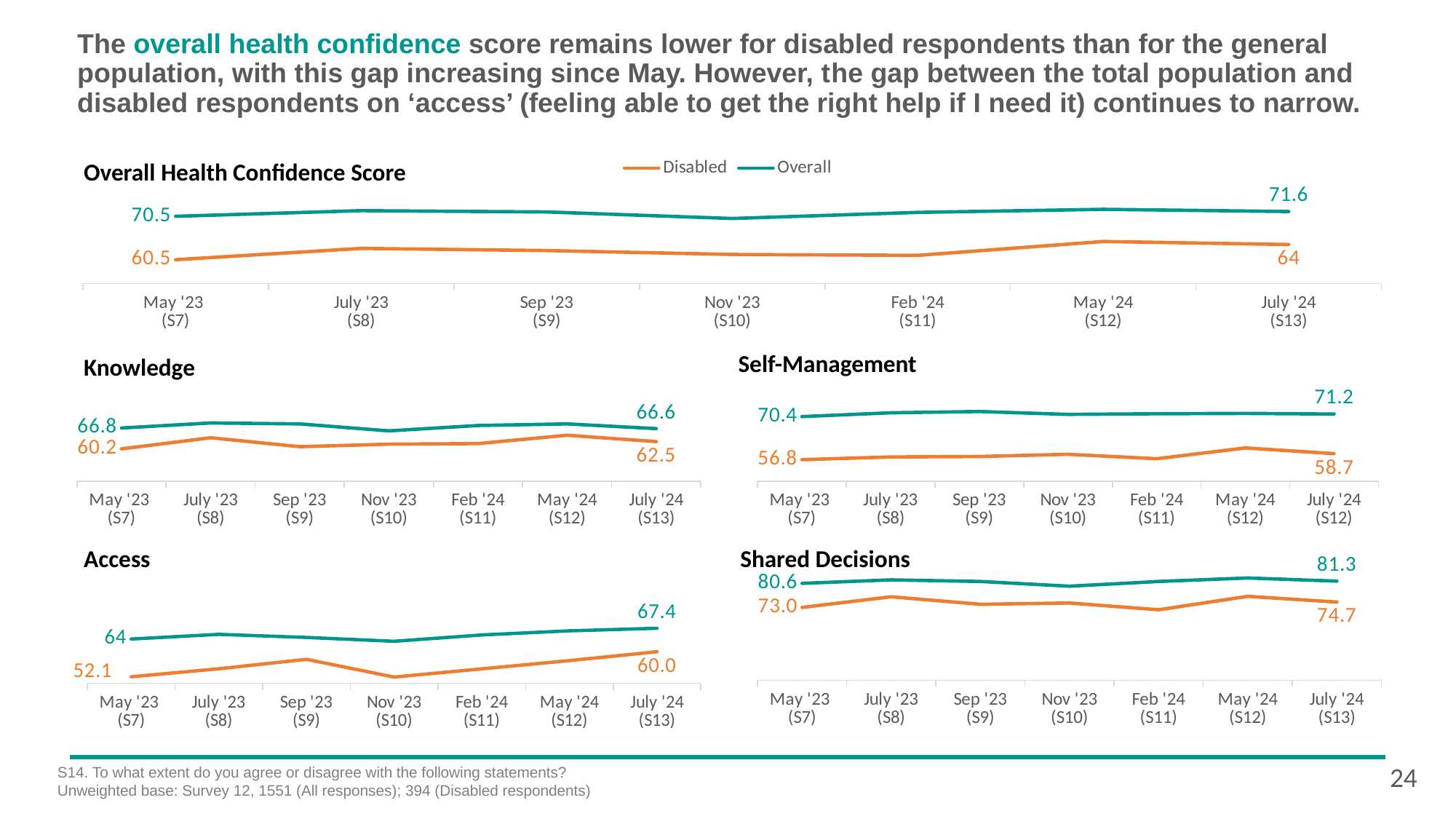
In the Shared Decisions chart, what is the Overall value for July '24 (S13)? 81.3 In the Access chart, does the Disabled line rise or fall between May '23 (S7) and July '24 (S13)? rise In the Access chart, what is the difference between the Overall and Disabled values at July '24 (S13)? 7.4 In the Overall Health Confidence Score chart, which colour is used for the Disabled series? orange In the Access chart, what is the Disabled value for May '23 (S7)? 52.1 In the Self-Management chart, what is the difference between the Overall and Disabled values at the last point (July '24)? 12.5 In the Overall Health Confidence Score chart, what is the Overall value for May '23 (S7)? 70.5 What type of chart is the Shared Decisions chart? line chart In the Knowledge chart, which series has the higher value at July '24 (S13), Disabled or Overall? Overall In the Overall Health Confidence Score chart, what is the Disabled value for July '24 (S13)? 64 How many survey waves are plotted along the x axis of the Overall Health Confidence Score chart? 7 How many series does the legend of the Overall Health Confidence Score chart list? 2